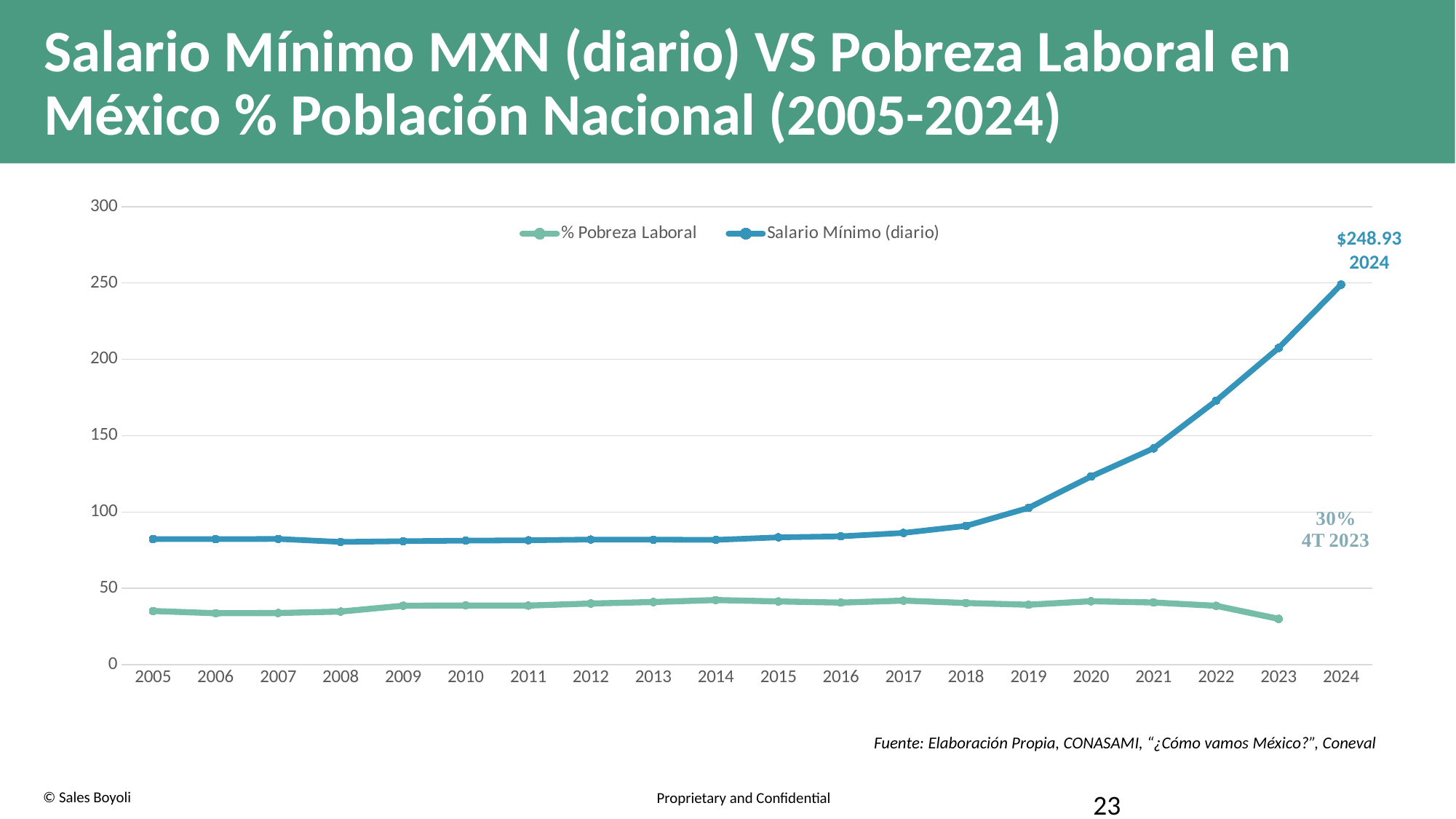
How many years are shown along the x axis? 20 In 2010, which series has the higher value, % Pobreza Laboral or Salario Mínimo (diario)? Salario Mínimo (diario) Does Salario Mínimo (diario) rise or fall from 2018 to 2024? rise In which year is % Pobreza Laboral lowest? 2023 How many series does the legend list? 2 What colour is the Salario Mínimo (diario) line? blue What is the value of % Pobreza Laboral in 2023? 30% What is the value of Salario Mínimo (diario) in 2024? $248.93 Is the value for Salario Mínimo (diario) in 2022 greater or less than 150? greater What kind of chart is shown on the slide? line chart Is the value for % Pobreza Laboral in 2014 greater or less than 50? less In which year is Salario Mínimo (diario) highest? 2024